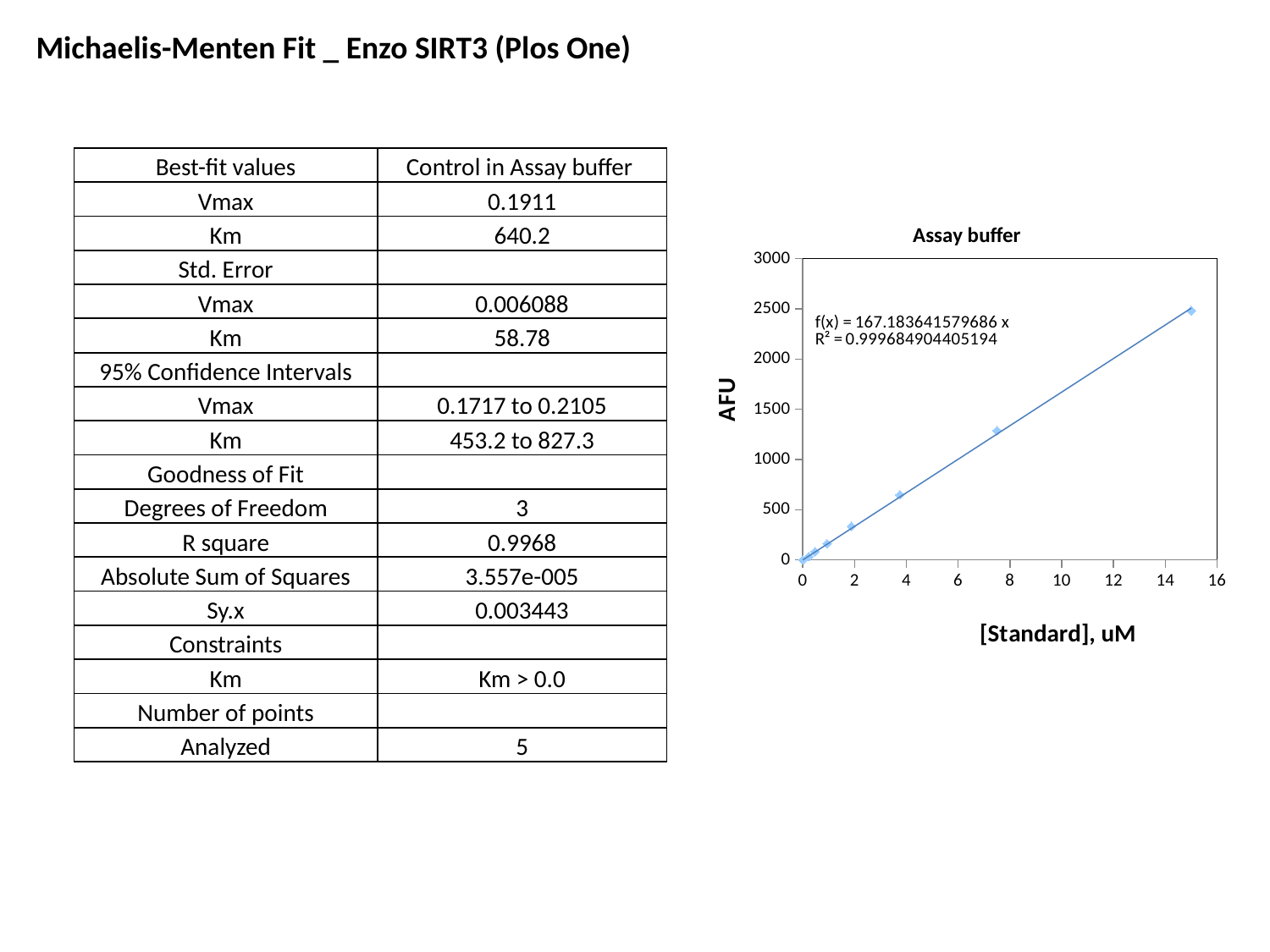
Is the AFU value for the point near 7.5 uM greater or less than 1500? less What is the title of the chart? Assay buffer Which point has the highest AFU value, the one at 15 uM or the one near 7.5 uM? the one at 15 uM What is the trendline equation printed on the chart? f(x) = 167.183641579686 x Is the AFU value for the point near 7.5 uM greater or less than 1000? greater Is the AFU value for the point near 4 uM greater or less than 1000? less What is the label of the y axis of the chart? AFU What R² value is printed on the chart? 0.999684904405194 What kind of chart is shown on the slide? scatter chart Do the AFU values rise or fall as [Standard], uM increases along the x axis? rise